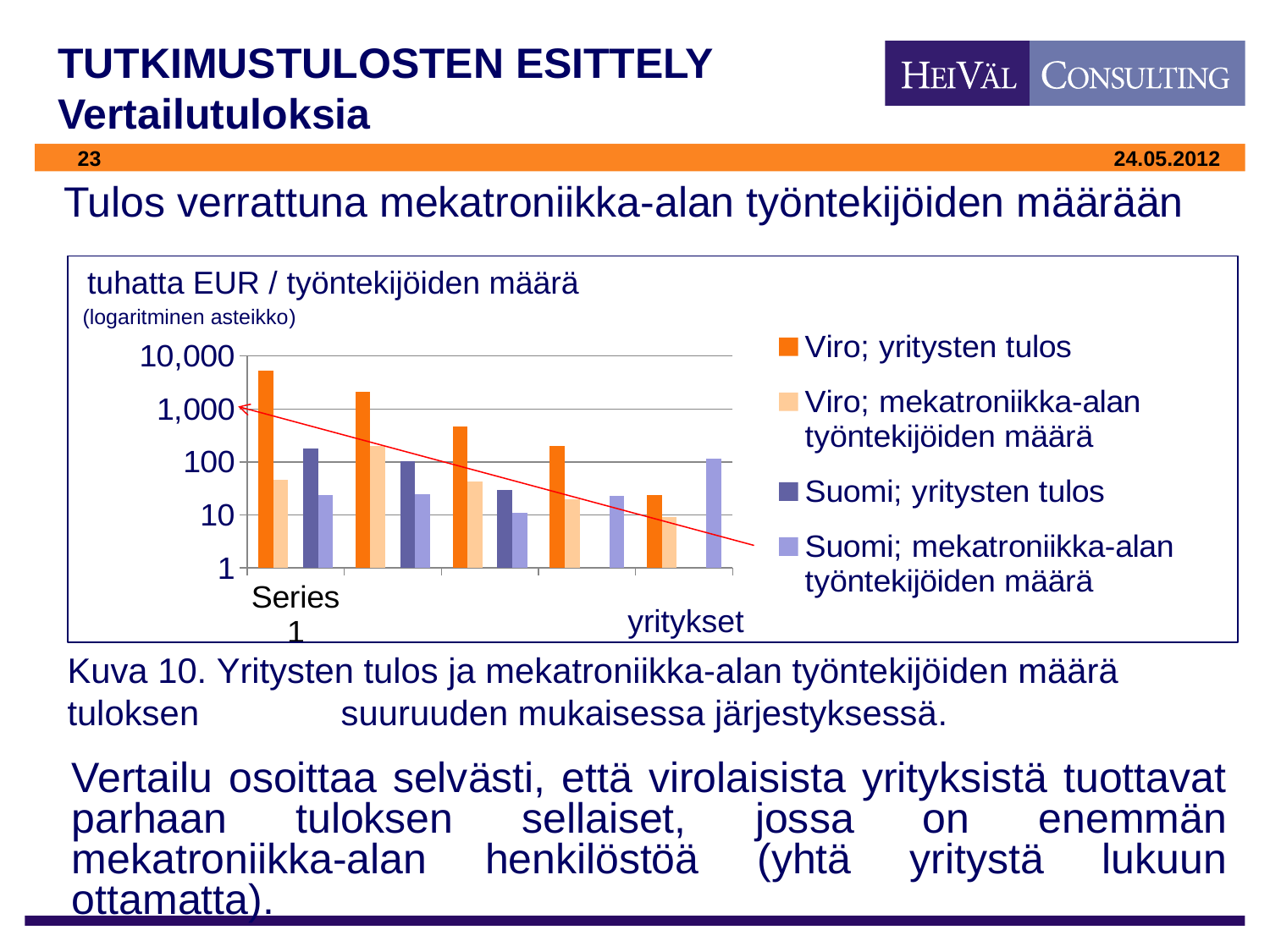
Which series has the tallest bar in the chart? Viro; yritysten tulos Is the value for 'Viro; mekatroniikka-alan työntekijöiden määrä' in Series 1 greater or less than 100? less How many series does the chart legend list? 4 What is the label on the x axis of the chart? yritykset How many groups of bars (categories) are plotted along the x axis? 5 In Series 1, which is larger: 'Viro; yritysten tulos' or 'Suomi; yritysten tulos'? Viro; yritysten tulos Is the value for 'Suomi; yritysten tulos' in Series 1 greater or less than 100? greater Do the values for 'Viro; yritysten tulos' rise or fall from left to right along the x axis? fall What kind of scale does the chart's vertical axis use, according to the note above the chart? logaritminen asteikko Is the value for 'Suomi; mekatroniikka-alan työntekijöiden määrä' in Series 1 greater or less than 100? less What kind of chart is shown on the slide? bar chart